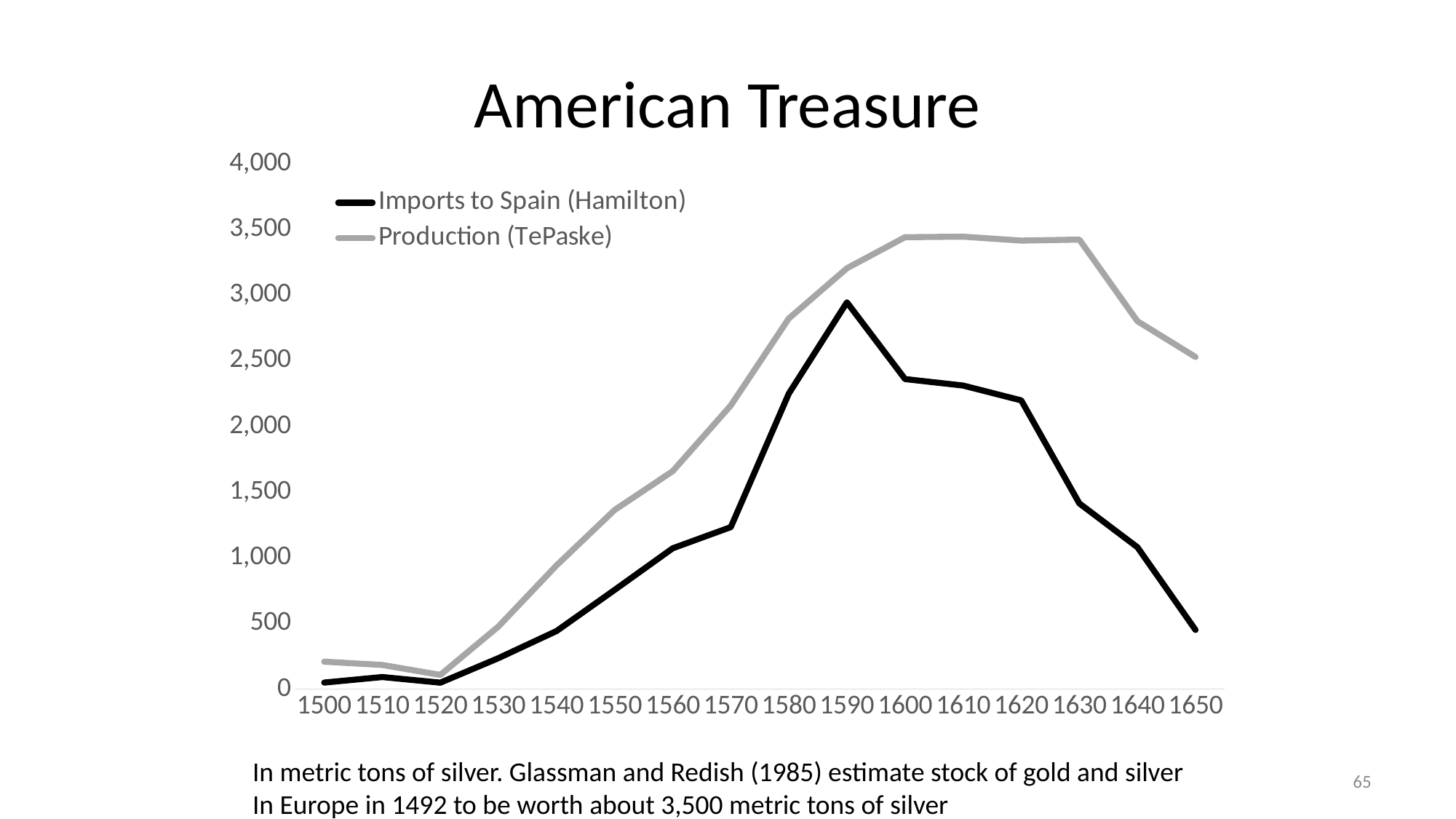
How many series does the legend list? 2 What kind of chart is shown on the slide? line chart Is the value for Imports to Spain (Hamilton) in 1650 greater or less than 1,000? less Does the Imports to Spain (Hamilton) series rise or fall between 1590 and 1650? fall Is the value for Production (TePaske) in 1600 greater or less than 3,000? greater Is the value for Production (TePaske) in 1500 greater or less than 500? less In 1600, which series has the higher value, Imports to Spain (Hamilton) or Production (TePaske)? Production (TePaske) How many years are marked along the x axis? 16 What is the title of the chart? American Treasure In which year does the Imports to Spain (Hamilton) series reach its highest value? 1590